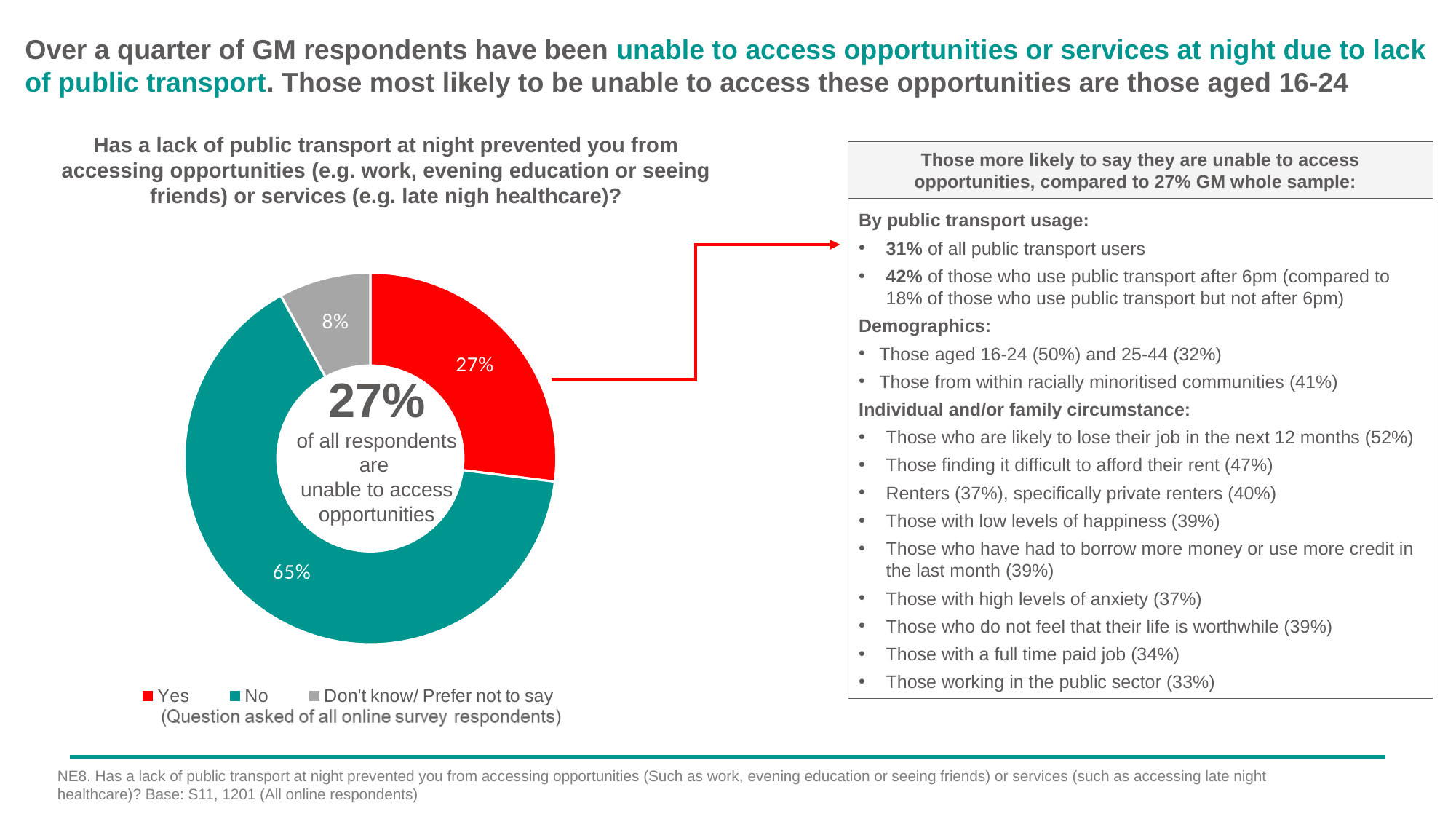
What figure is printed in the centre of the doughnut chart? 27% Which is larger, the share for 'Yes' or the share for 'Don't know/ Prefer not to say'? Yes Which response category has the largest share of the chart? No What kind of chart is shown on the slide? Doughnut (pie) chart What colour is used for the 'Yes' segment? Red What percentage of respondents answered 'Yes'? 27% What percentage of respondents answered 'Don't know/ Prefer not to say'? 8% How many categories does the chart show? 3 Which response category has the smallest share of the chart? Don't know/ Prefer not to say What is the difference in percentage points between the 'No' and 'Yes' shares? 38 What percentage of respondents answered 'No'? 65% What is the combined share of 'Yes' and 'No' responses? 92%